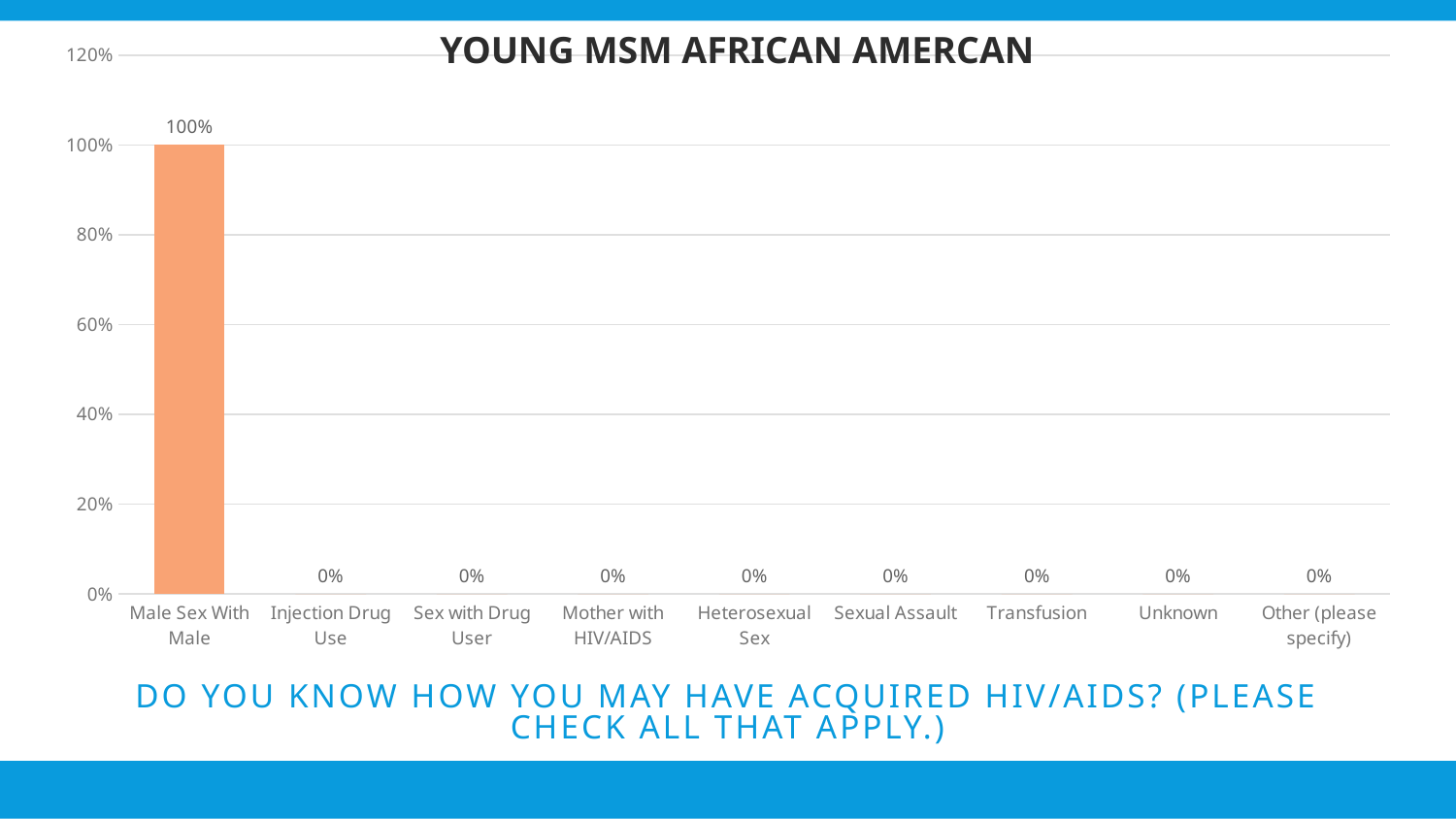
What is the value for Male Sex With Male? 100% What is the value for Sexual Assault? 0% What kind of chart is shown on the slide? bar chart What is the title of the chart? YOUNG MSM AFRICAN AMERCAN How many categories have a value of 0%? 8 What is the value for Injection Drug Use? 0% What is the difference between the values for Male Sex With Male and Transfusion? 100% Which category has the highest value? Male Sex With Male How many categories are shown on the x axis? 9 Is the value for Male Sex With Male greater or less than 80%? greater What is the value for Heterosexual Sex? 0% Which is larger, the value for Male Sex With Male or the value for Unknown? Male Sex With Male